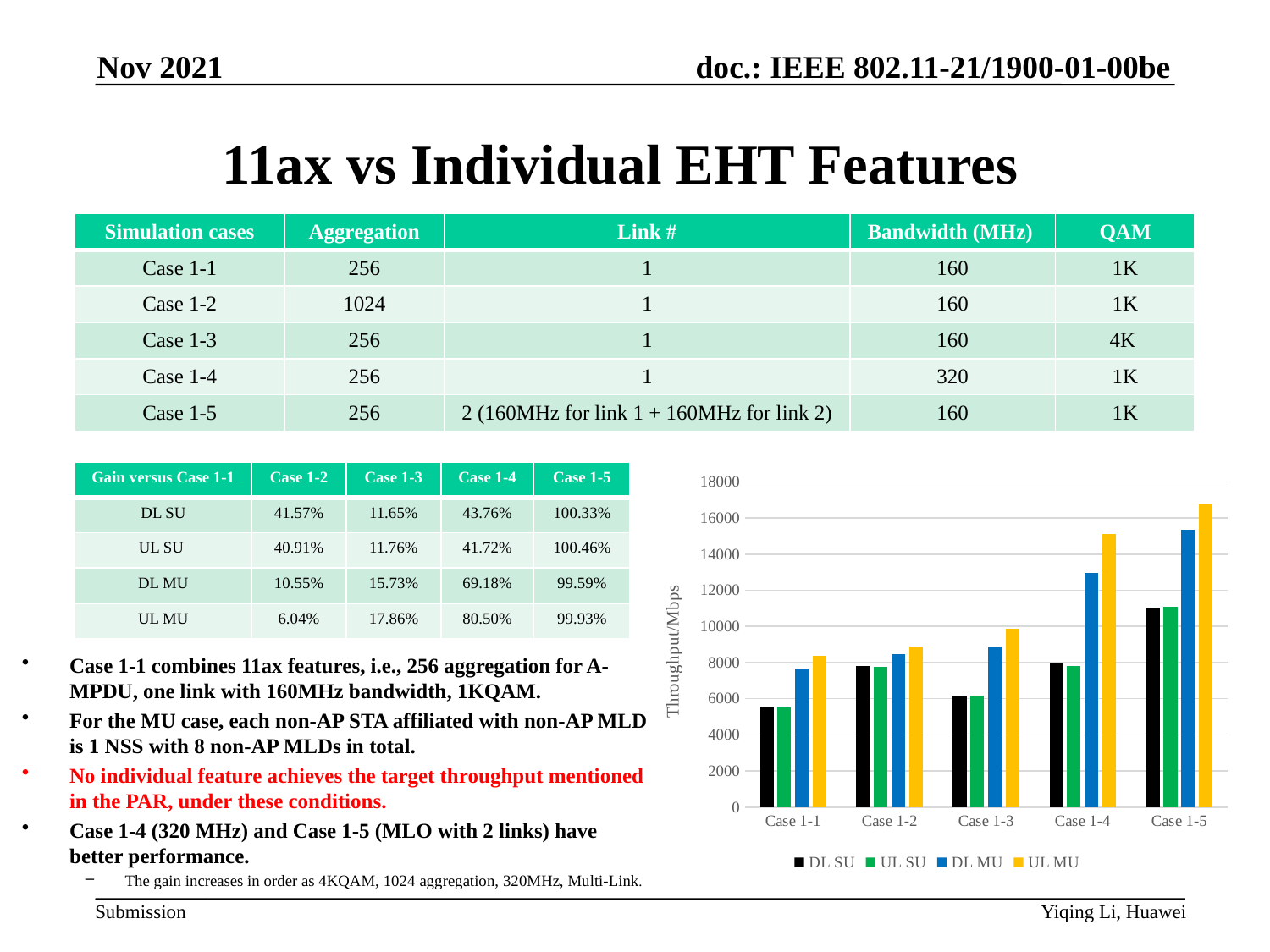
Which case has the highest UL MU throughput in the chart? Case 1-5 How many series does the chart legend list? 4 Which is larger in the chart: the UL MU throughput for Case 1-4 or the UL MU throughput for Case 1-3? Case 1-4 What kind of chart is shown on the slide? bar chart Is the DL MU throughput for Case 1-4 greater or less than 12000? greater Does the UL MU throughput rise or fall from Case 1-1 to Case 1-5 in the chart? rise Which case has the lowest UL MU throughput in the chart? Case 1-1 How many simulation cases are shown on the x axis of the chart? 5 What is the label on the vertical axis of the chart? Throughput/Mbps Which case has the highest DL MU throughput in the chart? Case 1-5 Is the DL SU throughput for Case 1-1 greater or less than 6000? less Is the UL MU throughput for Case 1-5 greater or less than 16000? greater